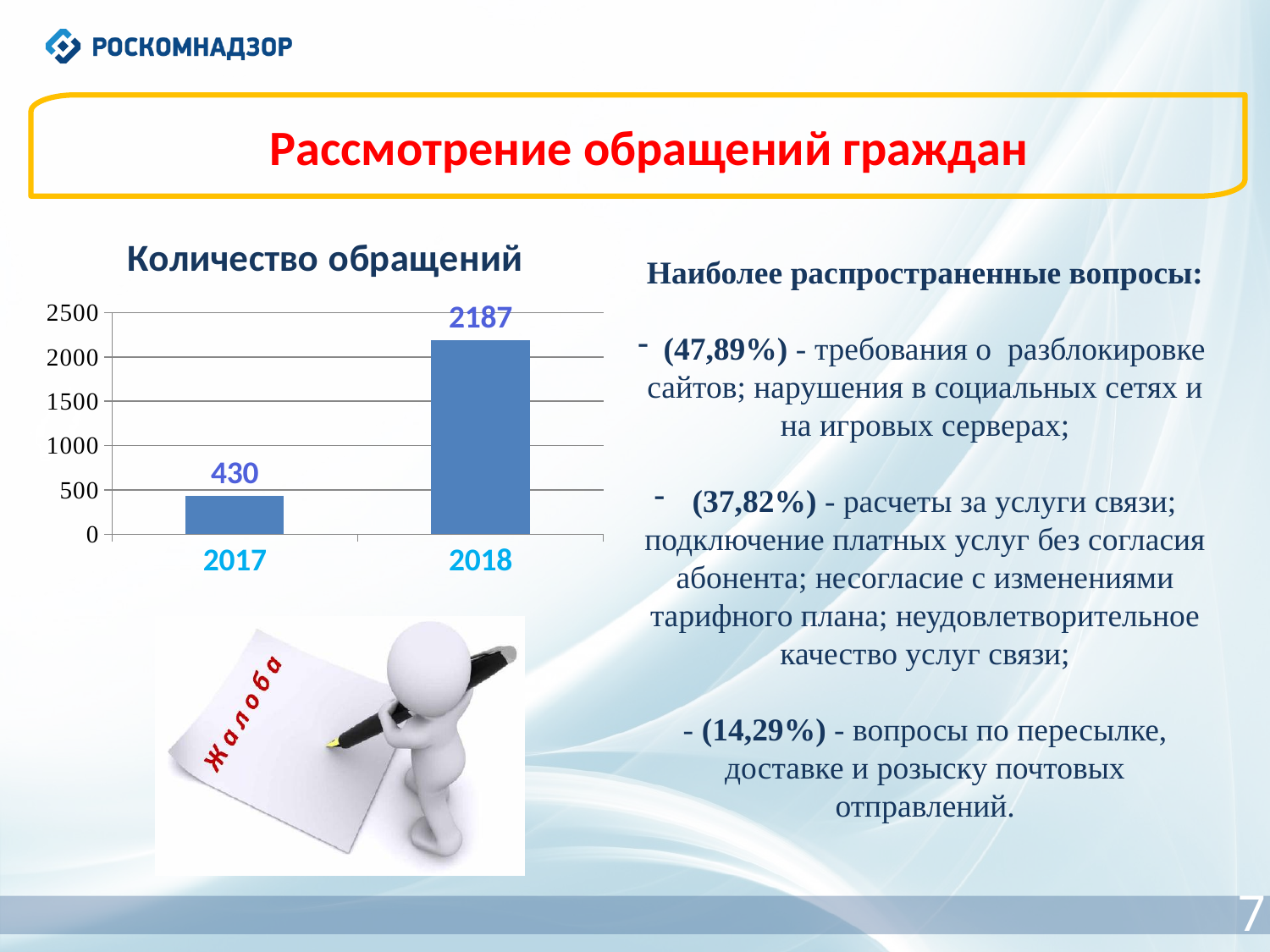
Is the value for 2018 greater or less than 2000? greater Which year has the highest number of appeals in the chart? 2018 Is the value for 2017 greater or less than 500? less Which is larger, the value for 2017 or the value for 2018? 2018 How many categories are shown on the x axis of the chart? 2 What is the value for 2017 in the chart? 430 What is the title of the chart? Количество обращений What kind of chart is shown on the slide? bar chart What is the difference between the values for 2018 and 2017? 1757 What is the value for 2018 in the chart? 2187 Do the values rise or fall from 2017 to 2018? rise Which year has the lowest number of appeals in the chart? 2017